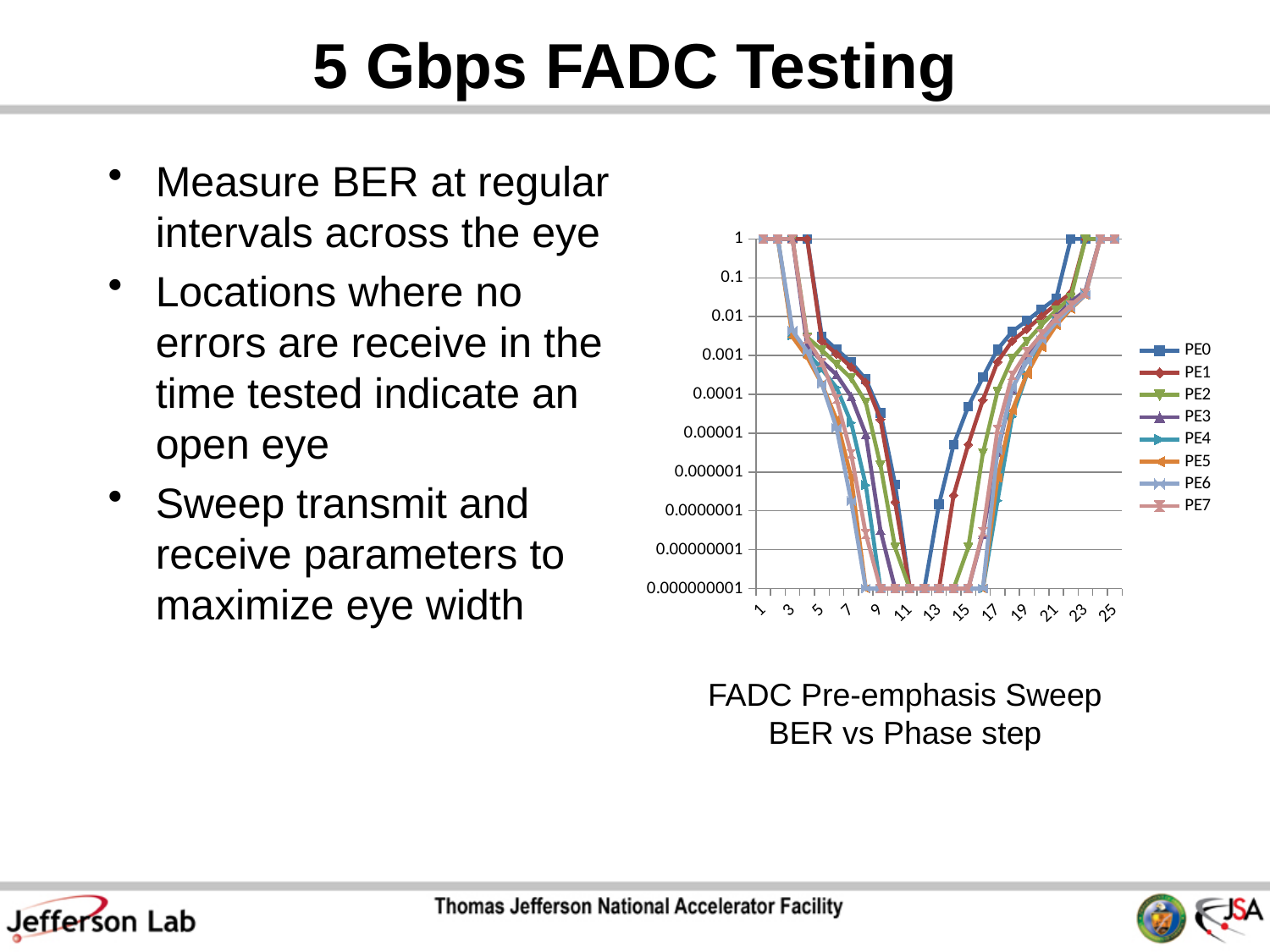
What kind of chart is shown on the slide? line chart How many series does the legend list? 8 How many tick labels are shown on the x axis? 13 At phase step 15, which series has the larger value, PE0 or PE7? PE0 Do the values rise or fall as the phase step goes from 1 to 11? fall What are the names of the series in the legend? PE0, PE1, PE2, PE3, PE4, PE5, PE6, PE7 What is the highest value labelled on the y axis? 1 What is the value of PE0 at phase step 23? 1 What is the value of PE0 at phase step 1? 1 What is the caption given below the chart? FADC Pre-emphasis Sweep BER vs Phase step Is the value for PE0 at phase step 21 greater or less than 0.001? greater What is the lowest value labelled on the y axis? 0.000000001